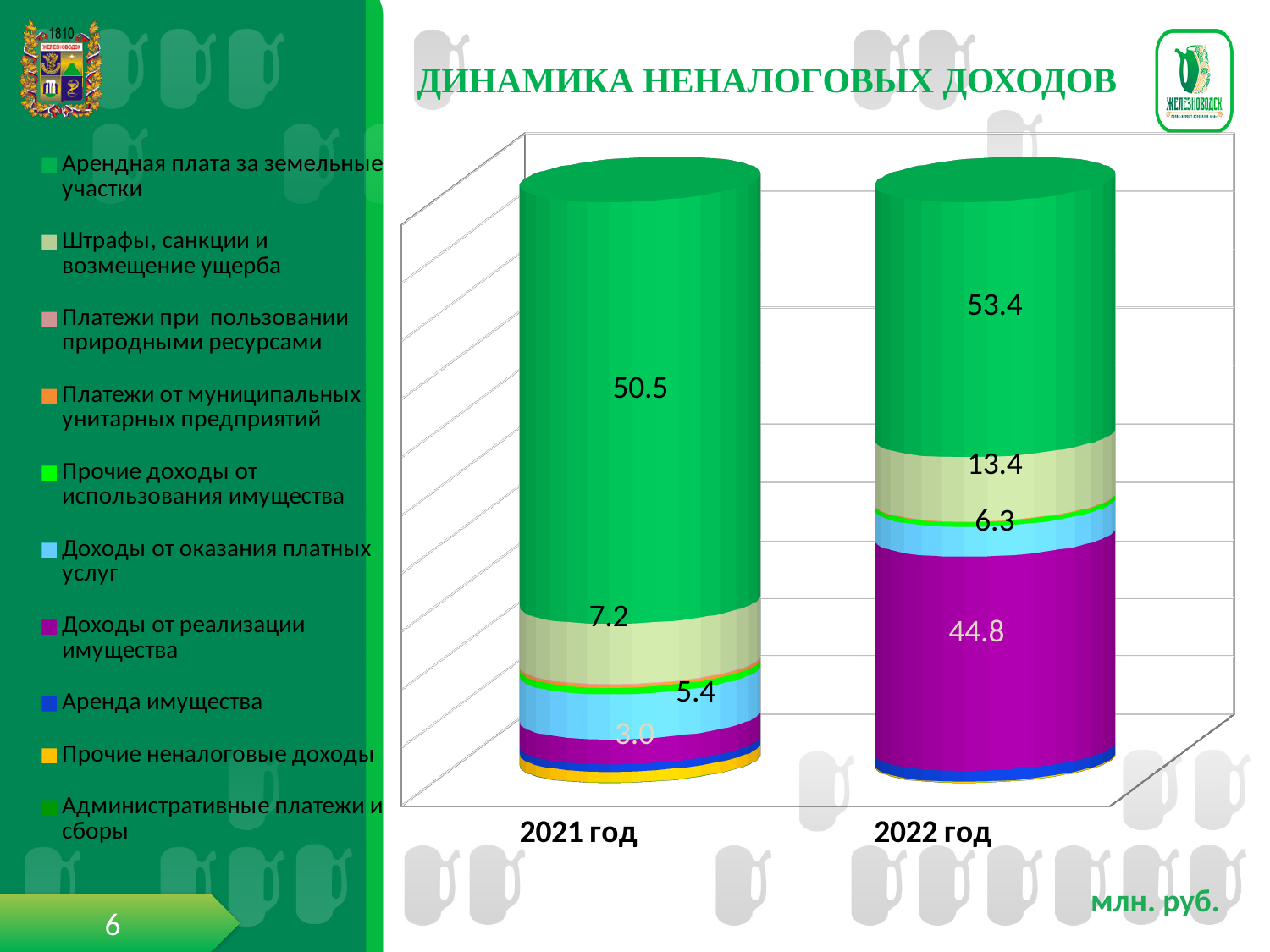
In what units are the values on the chart given? млн. руб. What is the value for Доходы от оказания платных услуг in 2021 год? 5.4 What is the value for Штрафы, санкции и возмещение ущерба in 2022 год? 13.4 What is the value for Доходы от реализации имущества in 2022 год? 44.8 How many series does the legend list? 10 What is the value for Арендная плата за земельные участки in 2022 год? 53.4 How many years (categories) are shown on the x axis? 2 By how much did Арендная плата за земельные участки increase from 2021 год to 2022 год? 2.9 What is the value for Арендная плата за земельные участки in 2021 год? 50.5 What kind of chart is shown on the slide? Stacked bar chart What is the difference between Доходы от реализации имущества in 2022 год and in 2021 год? 41.8 Which year has the larger value for Штрафы, санкции и возмещение ущерба, 2021 год or 2022 год? 2022 год